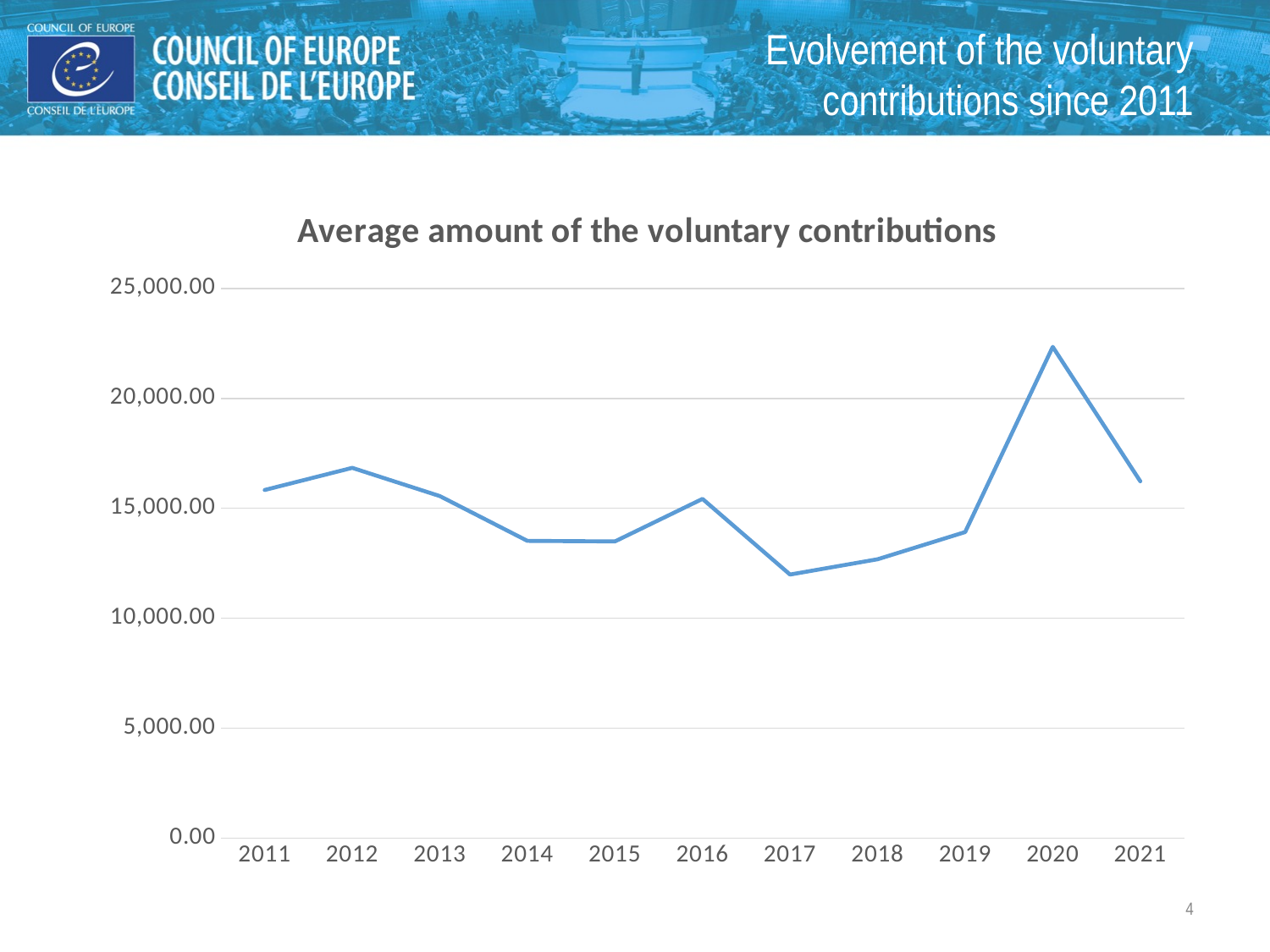
What is the title of the chart? Average amount of the voluntary contributions Is the value for 2014 greater or less than 15,000.00? less How many years are plotted on the x axis of the chart? 11 Is the value for 2017 greater or less than 15,000.00? less Does the value rise or fall from 2020 to 2021? fall Is the value for 2020 greater or less than 20,000.00? greater Which year has the larger value, 2012 or 2014? 2012 What kind of chart is shown on the slide? line chart Does the value rise or fall from 2019 to 2020? rise Which year has the lowest average amount of voluntary contributions? 2017 Which year has the highest average amount of voluntary contributions? 2020